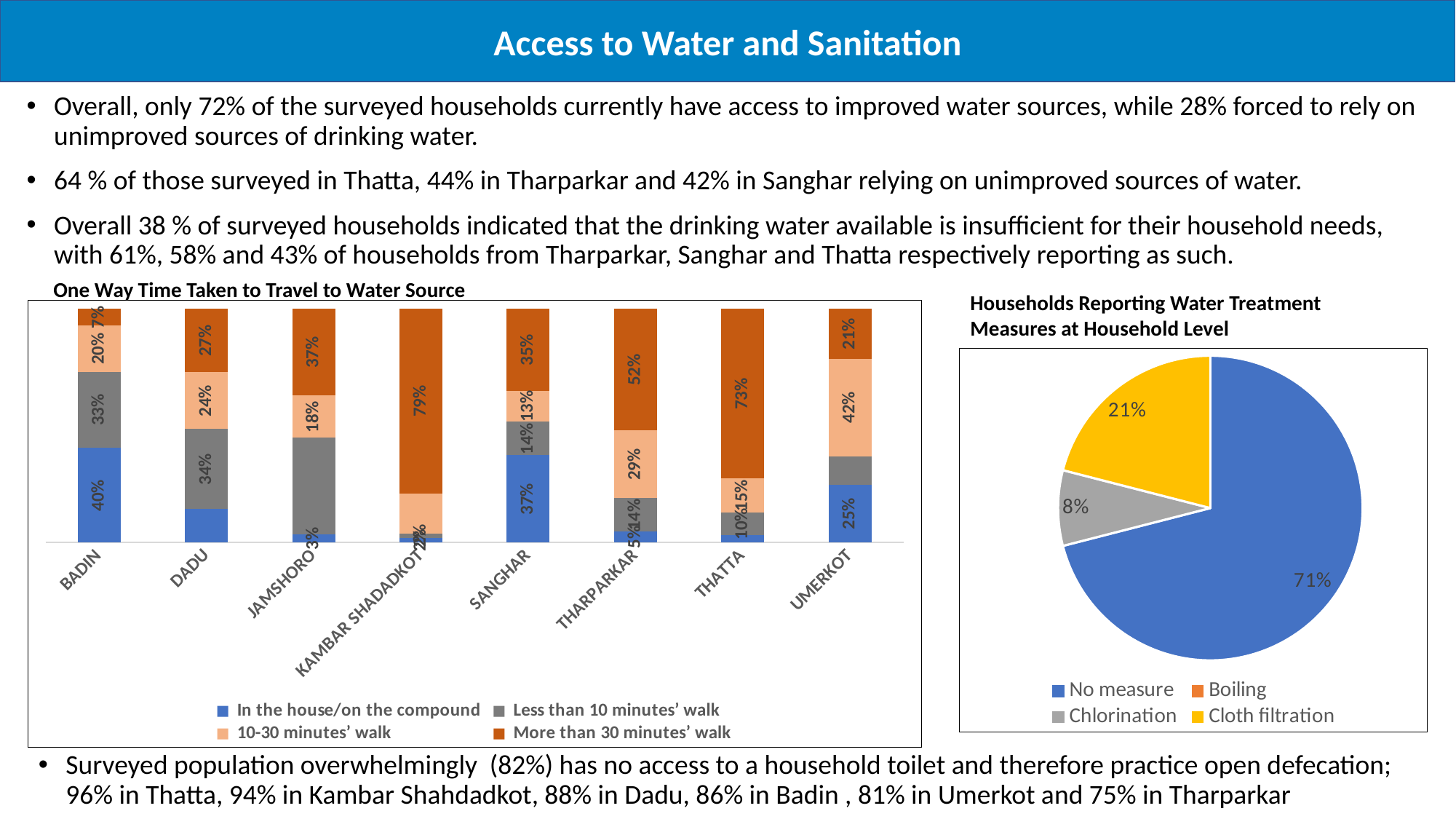
In the "One Way Time Taken to Travel to Water Source" chart, which is larger: the "More than 30 minutes' walk" share for Sanghar or for Badin? Sanghar What kind of chart is "One Way Time Taken to Travel to Water Source"? Stacked bar chart In the "One Way Time Taken to Travel to Water Source" chart, what percentage of households in Badin have water in the house/on the compound? 40% In the "Households Reporting Water Treatment Measures at Household Level" pie chart, what share of households report chlorination? 8% How many districts are shown on the x axis of the "One Way Time Taken to Travel to Water Source" chart? 8 In the "One Way Time Taken to Travel to Water Source" chart, what is the value for Umerkot in the "10-30 minutes' walk" series? 42% In the "Households Reporting Water Treatment Measures at Household Level" pie chart, what share of households report no measure? 71% In the "One Way Time Taken to Travel to Water Source" chart, which district has the highest share of households walking more than 30 minutes? Kambar Shadadkot In the "One Way Time Taken to Travel to Water Source" chart, what percentage of households in Kambar Shadadkot walk more than 30 minutes to a water source? 79% How many series does the legend of the "One Way Time Taken to Travel to Water Source" chart list? 4 In the "One Way Time Taken to Travel to Water Source" chart, what is the value for Tharparkar in the "More than 30 minutes' walk" series? 52% In the "Households Reporting Water Treatment Measures at Household Level" pie chart, which category has the largest slice? No measure